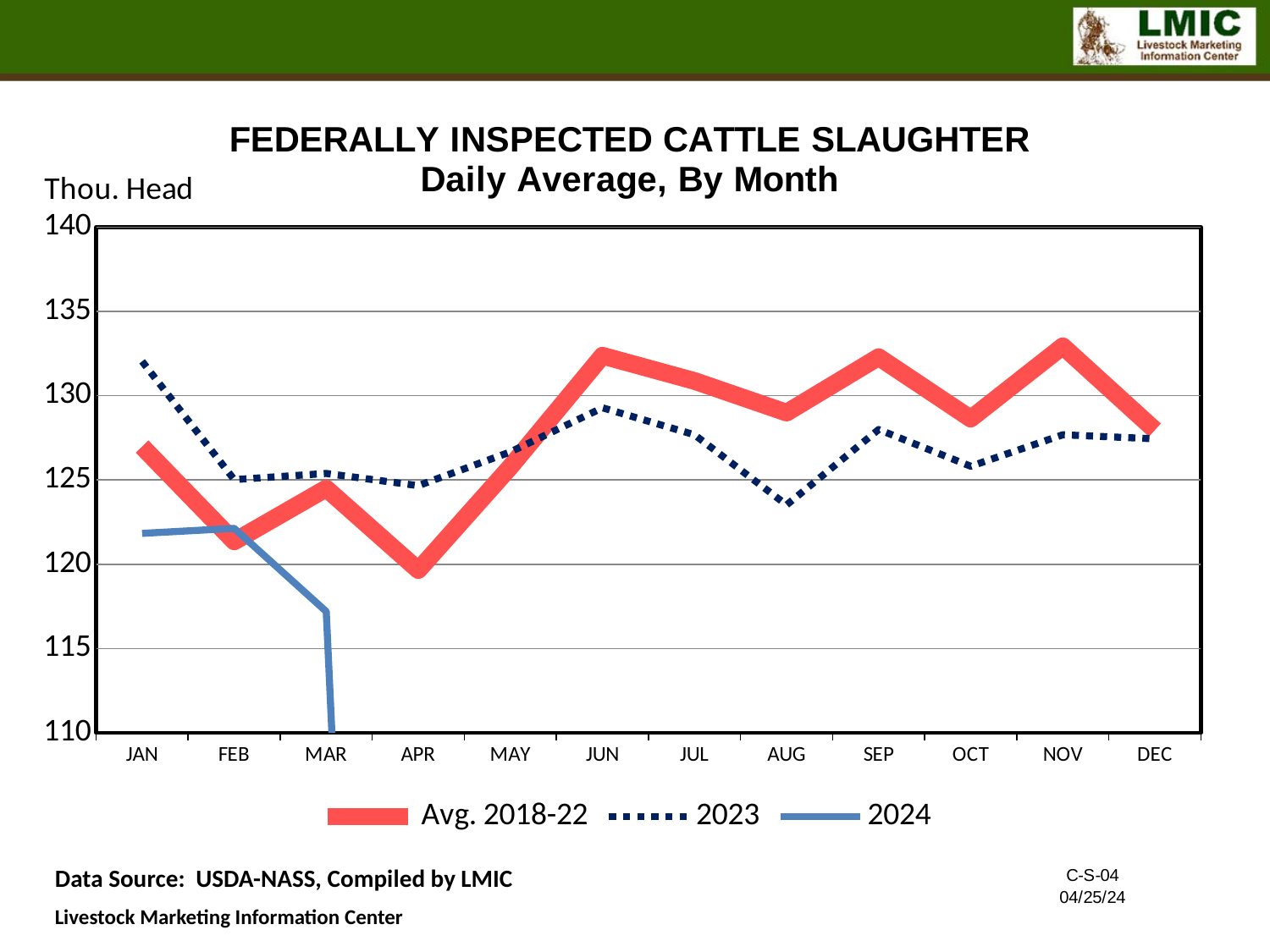
What unit is shown on the y axis label? Thou. Head In JAN, which series has the larger value, 2023 or Avg. 2018-22? 2023 Is the 2024 value for MAR greater or less than 115? greater Which month has the highest value for the 2023 series? JAN What kind of chart is shown on the slide? line chart How many months are shown on the x axis? 12 Which month has the lowest value for the 2023 series? AUG Which month has the lowest value for the Avg. 2018-22 series? APR How many series does the legend list? 3 Is the 2023 value for JAN greater or less than 130? greater In MAR, which series has the larger value, 2024 or Avg. 2018-22? Avg. 2018-22